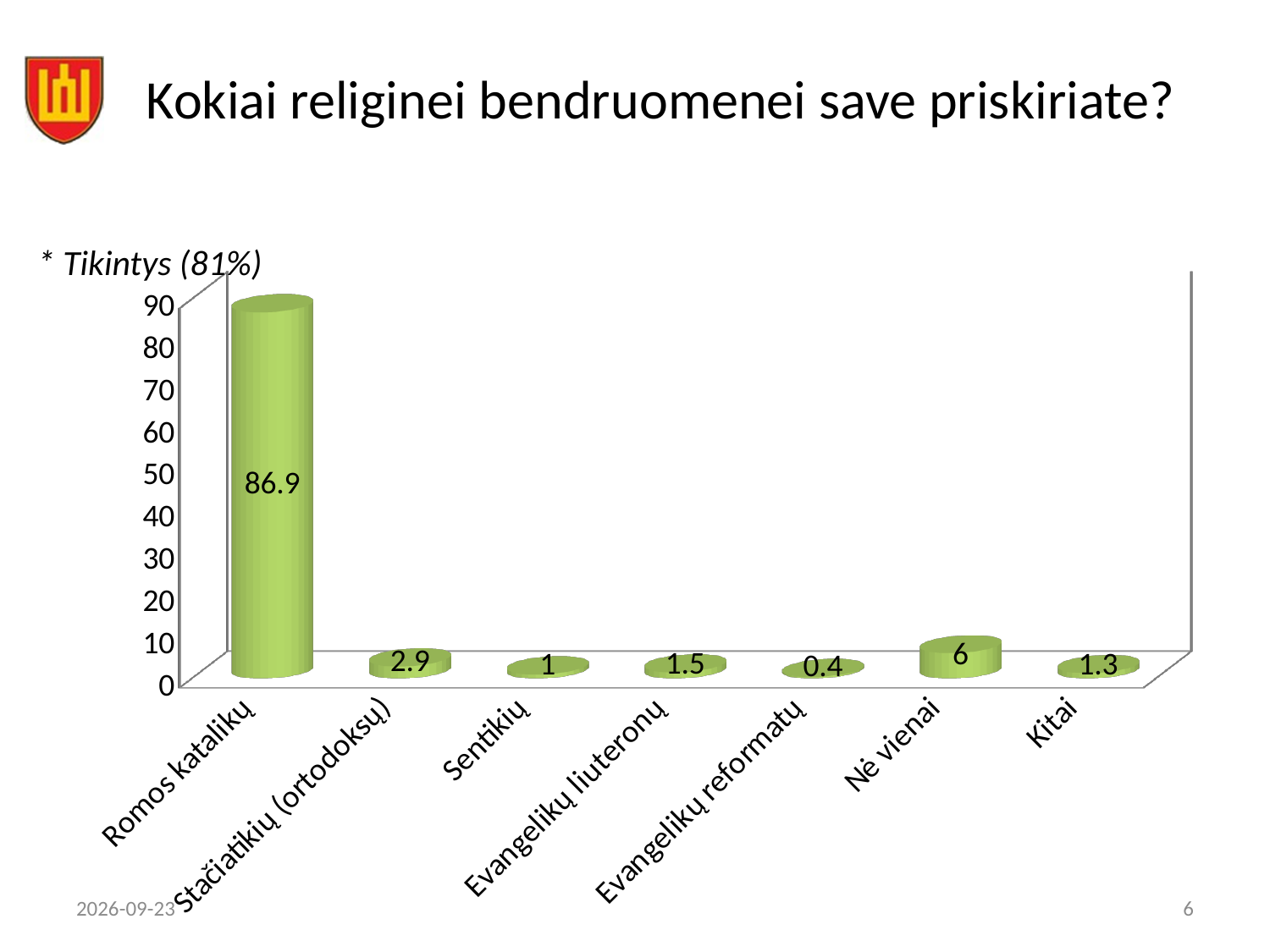
What is the value for Romos katalikų? 86.9 What is the value for Nė vienai? 6 What is the value for Stačiatikių (ortodoksų)? 2.9 Which category has the highest value? Romos katalikų How many categories are shown on the x axis? 7 Which category has the lowest value? Evangelikų reformatų Is the value for Romos katalikų greater or less than 80? greater Which is larger, the value for Stačiatikių (ortodoksų) or the value for Evangelikų liuteronų? Stačiatikių (ortodoksų) What kind of chart is shown on the slide? bar chart What is the title of the slide? Kokiai religinei bendruomenei save priskiriate? What is the difference between the values for Romos katalikų and Nė vienai? 80.9 What is the value for Evangelikų reformatų? 0.4